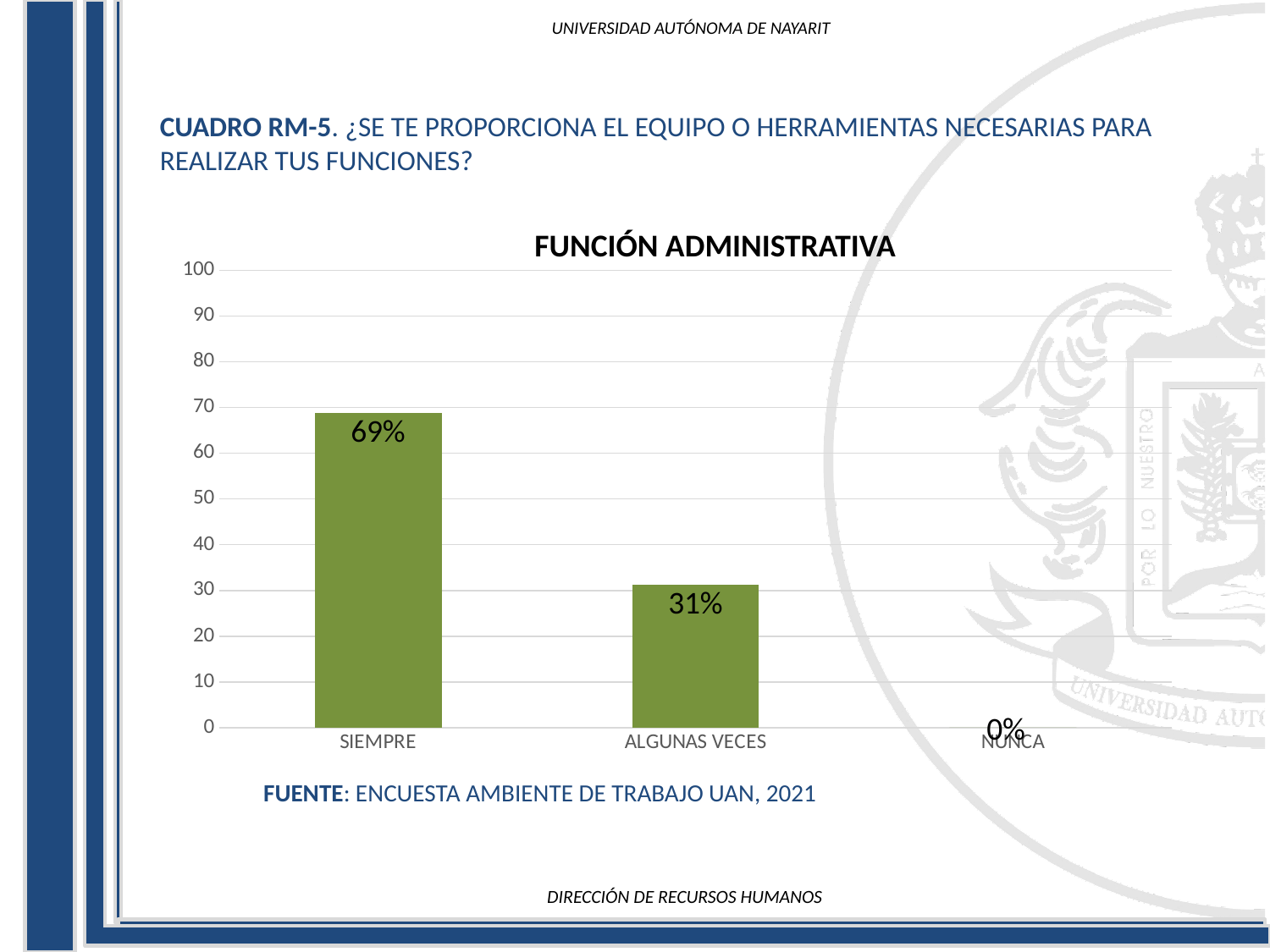
What is the value for NUNCA? 0% What kind of chart is shown on the slide? bar chart What is the difference between the values for SIEMPRE and ALGUNAS VECES? 38% Is the value for SIEMPRE greater or less than 60? greater What is the title of the chart? FUNCIÓN ADMINISTRATIVA How many categories are shown on the x axis? 3 Which is larger, the value for SIEMPRE or the value for ALGUNAS VECES? SIEMPRE What is the value for ALGUNAS VECES? 31% Which category has the lowest value? NUNCA Is the value for ALGUNAS VECES greater or less than 40? less What is the value for SIEMPRE? 69% Which category has the highest value? SIEMPRE